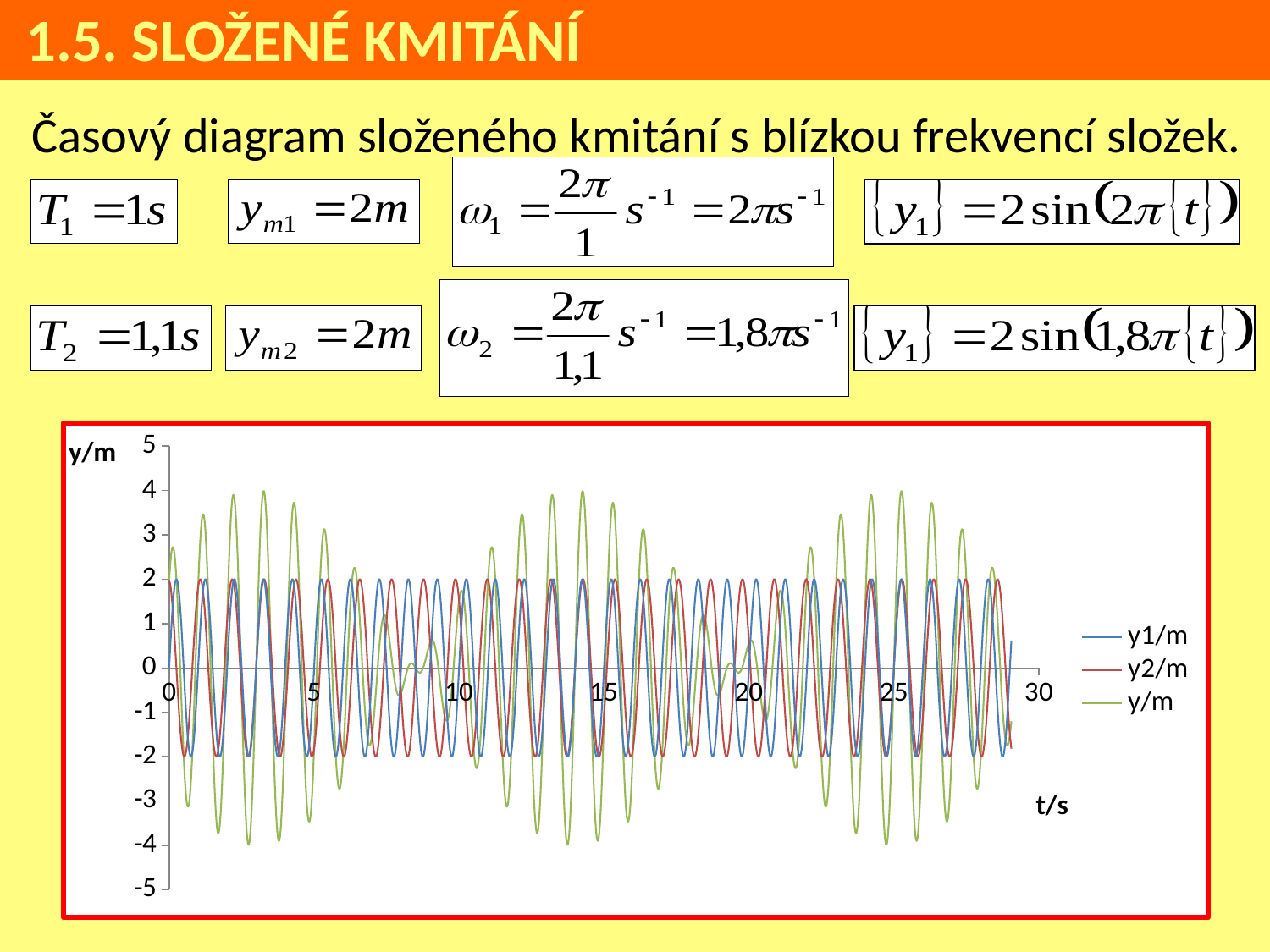
Is the maximum value reached by the y/m series greater or less than 3? greater Which series reaches the highest peak values in the chart, y1/m or y/m? y/m What is the largest tick value shown on the horizontal axis of the chart? 30 What is the label of the horizontal axis of the chart? t/s What is the highest tick value shown on the vertical axis of the chart? 5 What is the lowest tick value shown on the vertical axis of the chart? -5 How many series does the chart legend list? 3 Which colour is used for the y/m series in the chart? green What kind of chart is shown on the slide? line chart What is the label of the vertical axis of the chart? y/m Is the maximum value reached by the y1/m series greater or less than 3? less What are the three series named in the chart legend? y1/m, y2/m, y/m